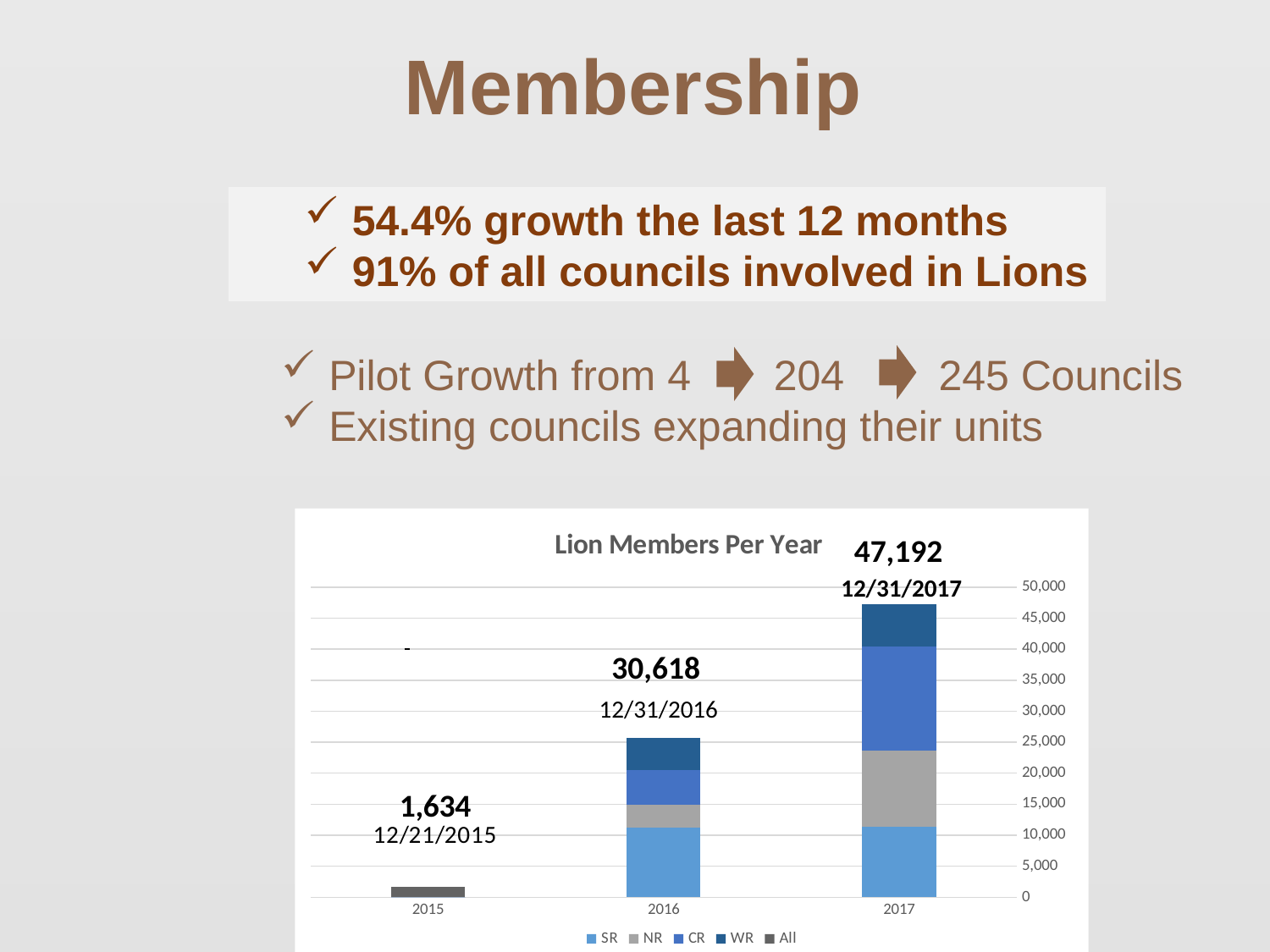
What is the total number of Lion members shown for 2016? 30,618 How many series does the legend list? 5 Which year has the highest total number of Lion members? 2017 What is the total number of Lion members shown for 2017? 47,192 What is the difference between the 2016 total and the 2015 total? 28,984 What is the title of the chart? Lion Members Per Year Which year has the lowest total number of Lion members? 2015 How many years are shown on the x axis? 3 What is the difference between the 2017 total and the 2016 total? 16,574 What type of chart is shown on the slide? Stacked bar chart Do the total Lion members rise or fall from 2015 to 2017? Rise What is the total number of Lion members shown for 2015? 1,634